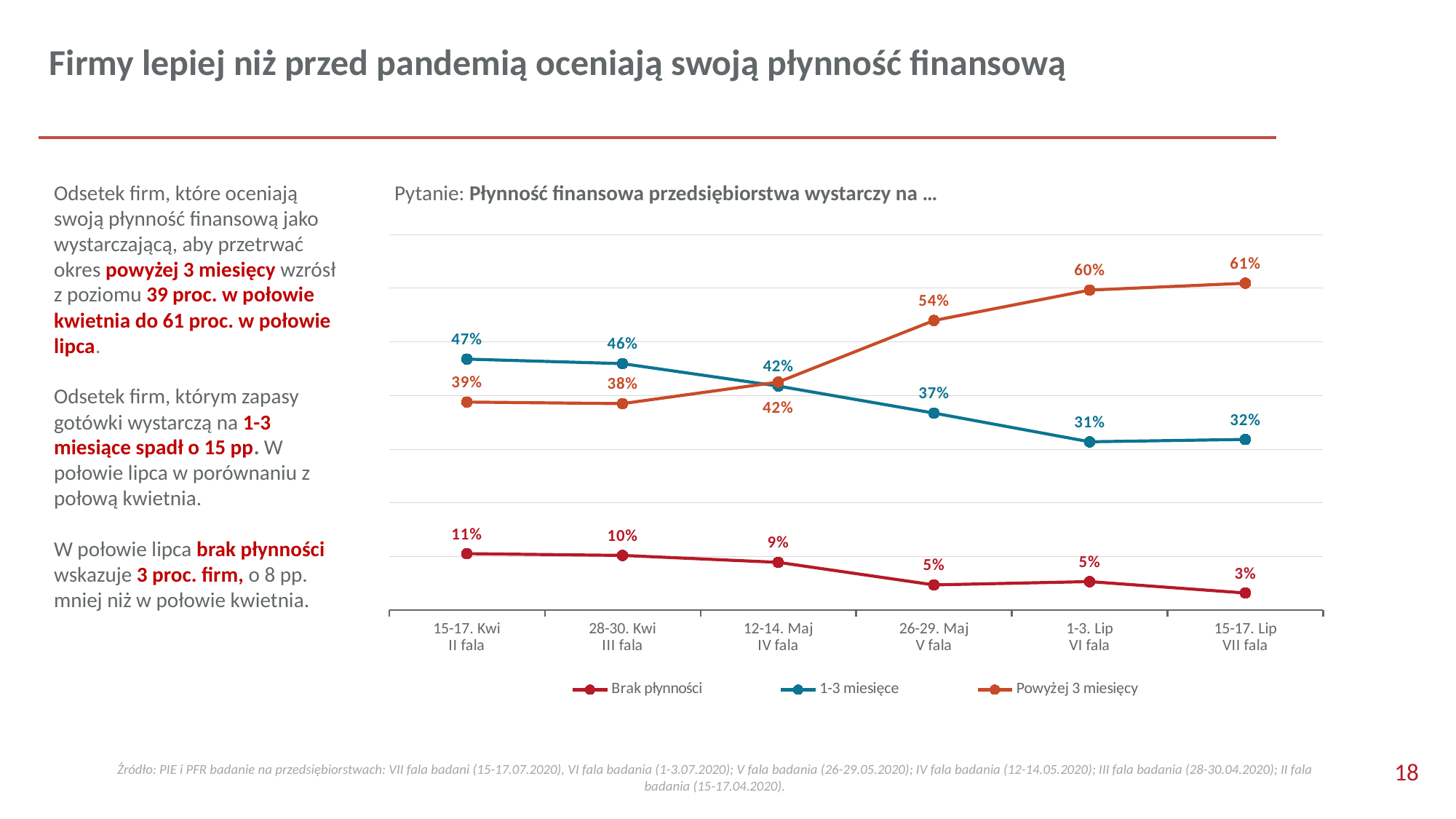
What is the value for 'Brak płynności' in the V fala (26-29. Maj)? 5% In which wave does 'Powyżej 3 miesięcy' reach its highest value? 15-17. Lip VII fala How many series does the chart legend list? 3 In which wave is 'Brak płynności' at its lowest value? 15-17. Lip VII fala What is the difference between the 'Powyżej 3 miesięcy' values in the VII fala and the II fala? 22 percentage points In the VI fala (1-3. Lip), which is larger: '1-3 miesięce' or 'Powyżej 3 miesięcy'? Powyżej 3 miesięcy How many survey waves (x-axis categories) are plotted on the chart? 6 What type of chart is shown on the slide? line chart What is the value for 'Powyżej 3 miesięcy' in the VII fala (15-17. Lip)? 61% What is the overall trend of the '1-3 miesięce' series from the II fala to the VII fala? falling Which series is drawn in red on the chart? Brak płynności What is the value for '1-3 miesięce' in the II fala (15-17. Kwi)? 47%